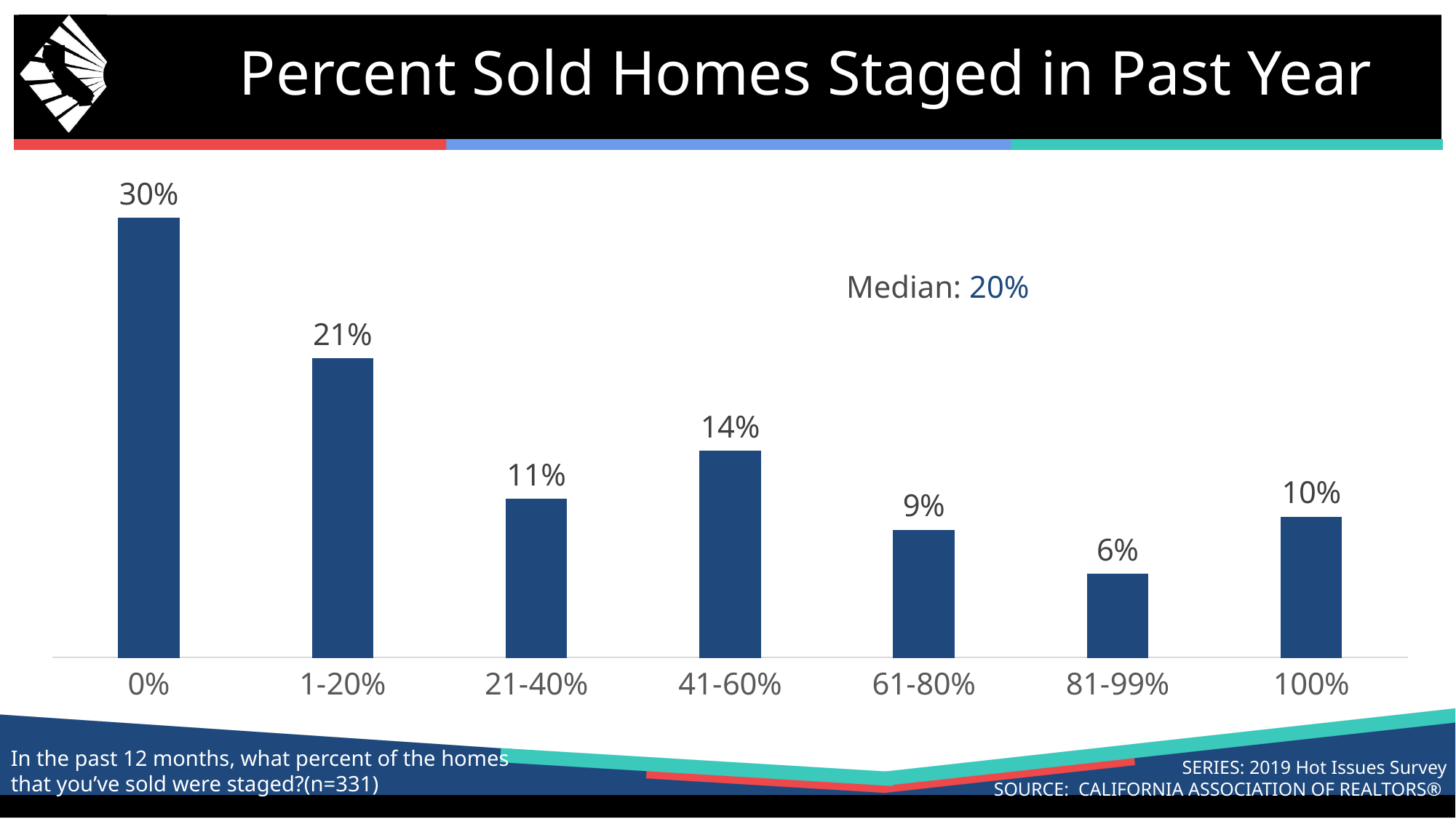
What is the value for the 41-60% category? 14% How many categories are shown on the x axis? 7 What is the value for the 0% category? 30% What is the median value stated on the slide? 20% Which is larger, the value for 21-40% or the value for 100%? 21-40% What is the difference between the values for 61-80% and 81-99%? 3% What kind of chart is shown on the slide? bar chart Which category has the lowest value? 81-99% What is the title of the chart? Percent Sold Homes Staged in Past Year What is the difference between the values for 0% and 1-20%? 9% What is the value for the 100% category? 10% Which category has the highest value? 0%